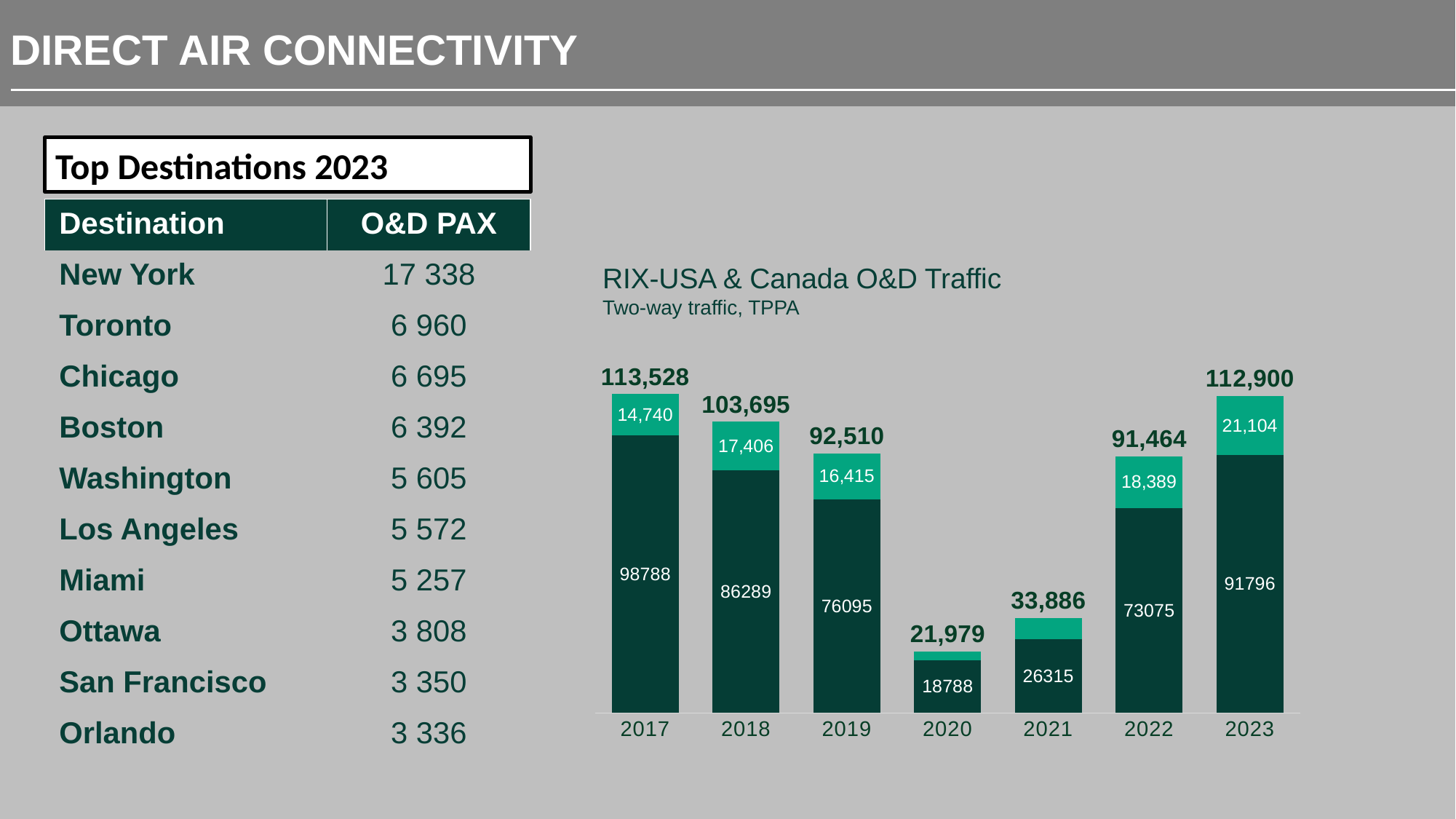
What value is printed in the dark green segment of the 2019 bar? 76095 What is the total value shown above the 2023 bar in the RIX-USA & Canada O&D Traffic chart? 112,900 Which year has the highest total in the RIX-USA & Canada O&D Traffic chart? 2017 What is the difference between the totals for 2017 and 2023? 628 What is the subtitle printed under the chart title RIX-USA & Canada O&D Traffic? Two-way traffic, TPPA What value is printed in the light green segment of the 2022 bar? 18,389 What kind of chart is the RIX-USA & Canada O&D Traffic chart? Stacked bar chart Do the totals rise or fall from 2017 to 2020 in the RIX-USA & Canada O&D Traffic chart? Fall Which year has a larger total, 2018 or 2022? 2018 Which year has the lowest total in the RIX-USA & Canada O&D Traffic chart? 2020 What is the total value shown above the 2017 bar in the RIX-USA & Canada O&D Traffic chart? 113,528 How many years are shown on the x axis of the RIX-USA & Canada O&D Traffic chart? 7